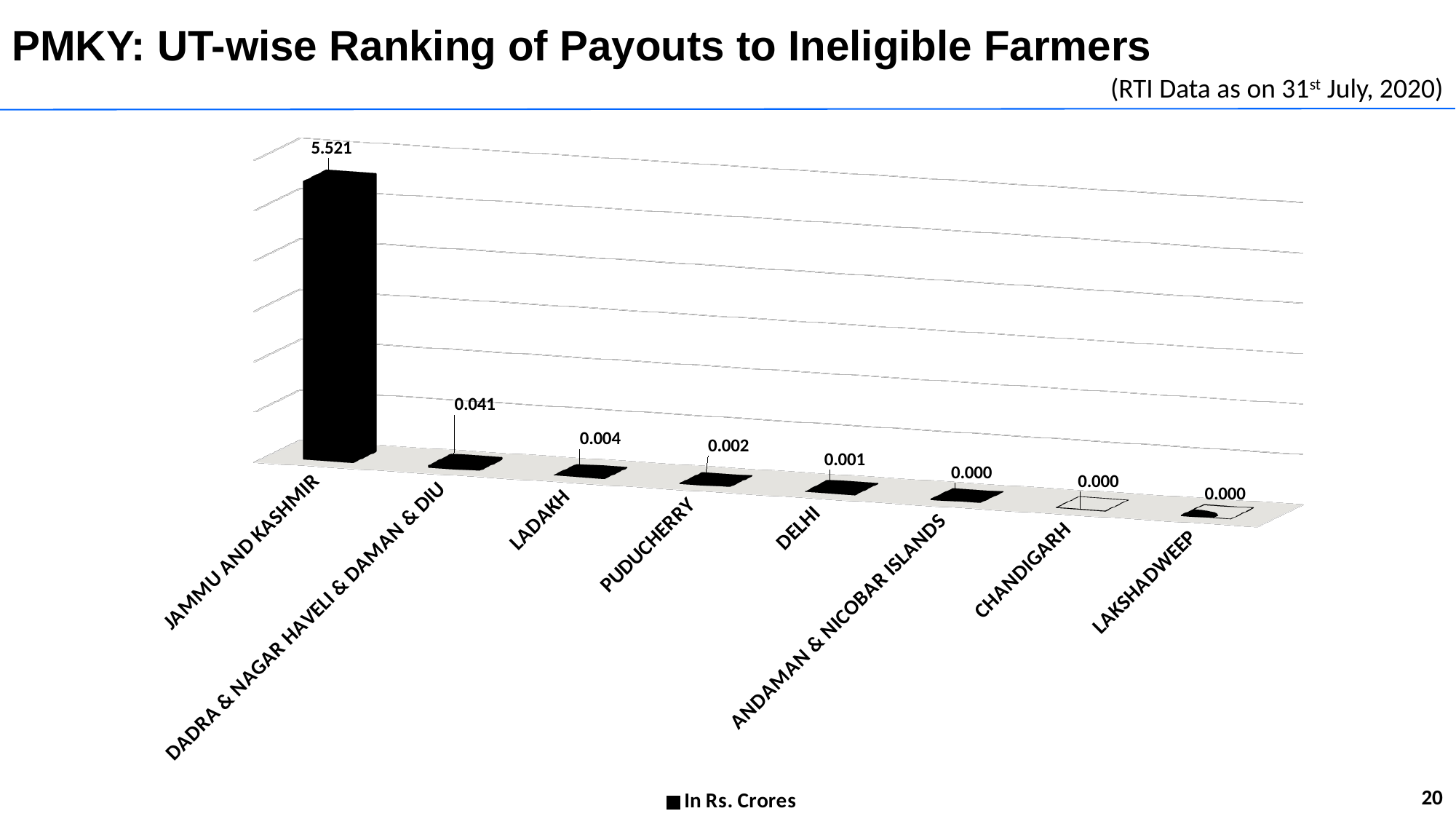
What is the value for Jammu and Kashmir? 5.521 Which UT has the highest value? Jammu and Kashmir What is the value for Ladakh? 0.004 What kind of chart is shown on the slide? Bar chart What is the difference between the values for Jammu and Kashmir and Dadra & Nagar Haveli & Daman & Diu? 5.480 What is the value for Delhi? 0.001 How many UTs are shown on the chart? 8 Which is larger, the value for Puducherry or the value for Delhi? Puducherry What is the difference between the values for Ladakh and Puducherry? 0.002 What is the value for Dadra & Nagar Haveli & Daman & Diu? 0.041 What is the value for Chandigarh? 0.000 What unit does the legend say the values are in? In Rs. Crores